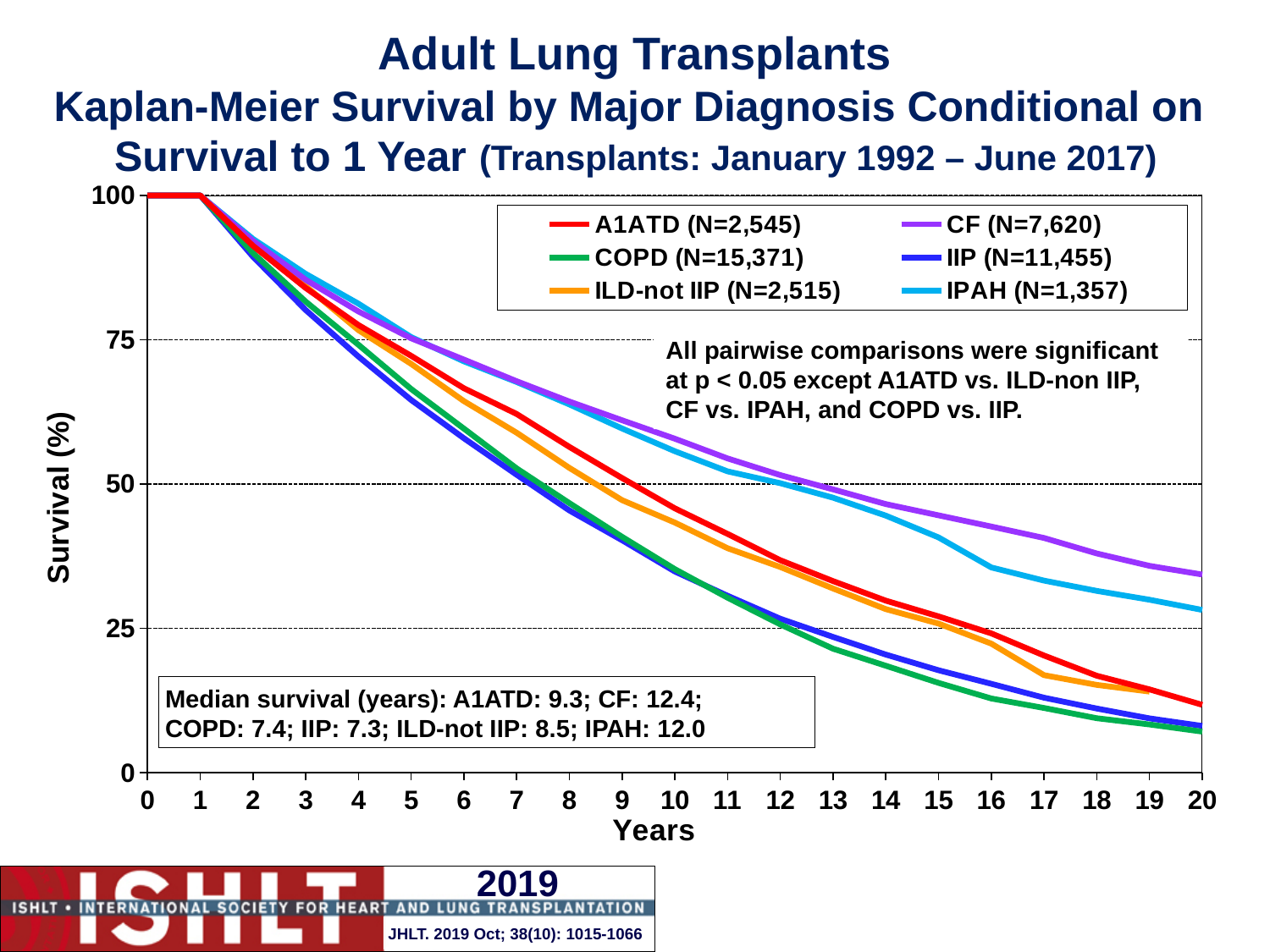
At 10 years, which group has higher survival, A1ATD or COPD? A1ATD Is the survival for the CF group at 20 years greater or less than 25? greater Which diagnosis group has the highest median survival? CF According to the legend, how many patients (N) are in the COPD group? 15,371 What is the median survival in years for the CF group? 12.4 Which diagnosis group has the lowest median survival? IIP Do the survival curves rise or fall as years increase along the x axis? fall Is the survival for the COPD group at 20 years greater or less than 25? less What is the difference in median survival (years) between CF and A1ATD? 3.1 What kind of chart is shown on the slide? line chart What is the median survival in years for the ILD-not IIP group? 8.5 How many diagnosis groups (series) does the legend list? 6